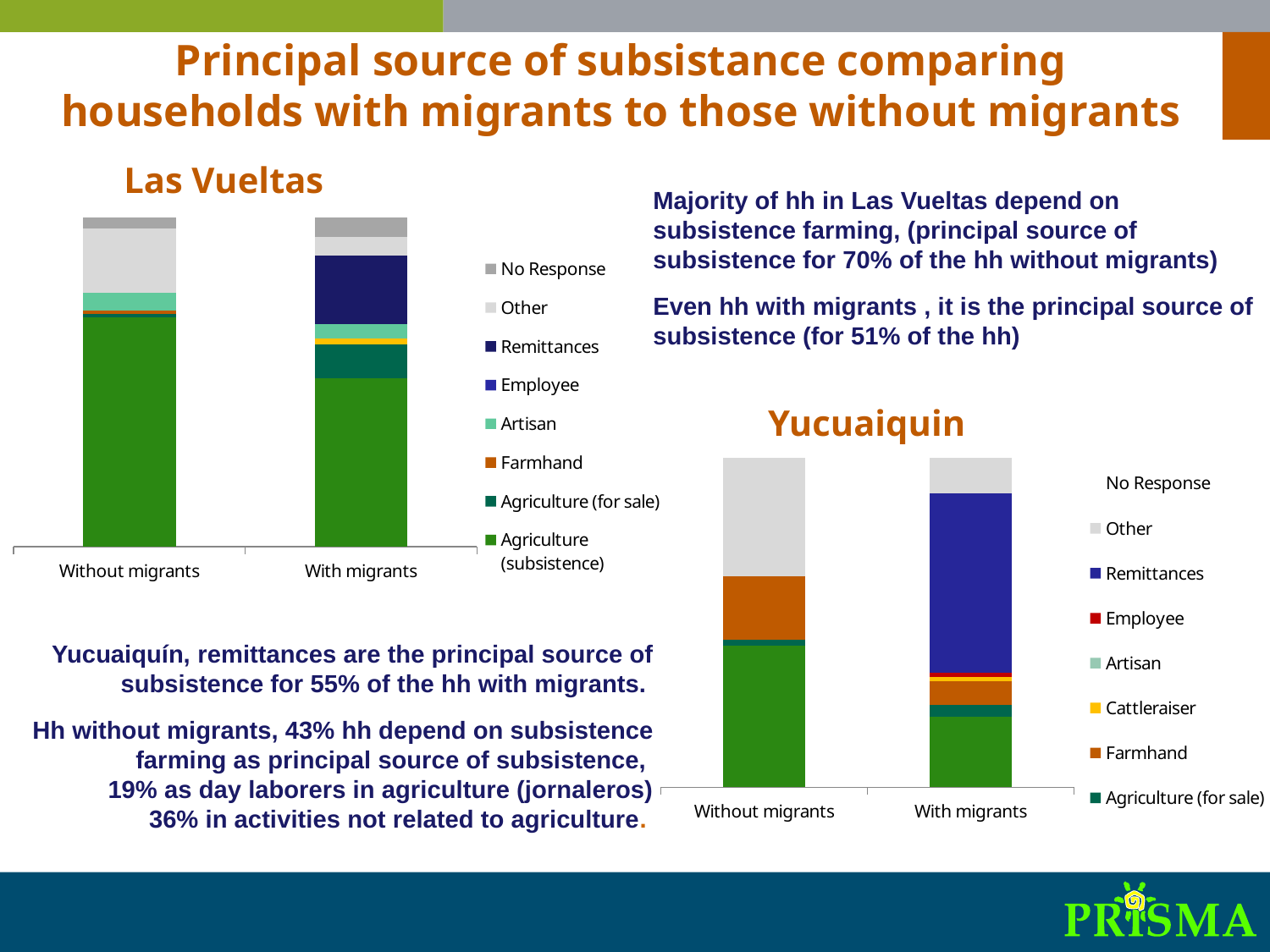
How many series does the legend of the Las Vueltas chart list? 8 In the Las Vueltas chart, which series forms the largest segment of the Without migrants bar? Agriculture (subsistence) How many series does the legend of the Yucuaiquin chart list? 8 In the Yucuaiquin chart, which series forms the largest segment of the With migrants bar? Remittances In the Yucuaiquin chart, is the Remittances segment larger for Without migrants or With migrants? With migrants In the Yucuaiquin chart, is the Other segment larger for Without migrants or With migrants? Without migrants Which legend entry appears in the Yucuaiquin chart but not in the Las Vueltas chart? Cattleraiser What kind of chart is the Yucuaiquin chart? Stacked bar chart How many categories are shown on the x axis of the Yucuaiquin chart? 2 In the Las Vueltas chart, is the Agriculture (subsistence) segment larger for Without migrants or With migrants? Without migrants How many categories are shown on the x axis of the Las Vueltas chart? 2 What kind of chart is the Las Vueltas chart? Stacked bar chart